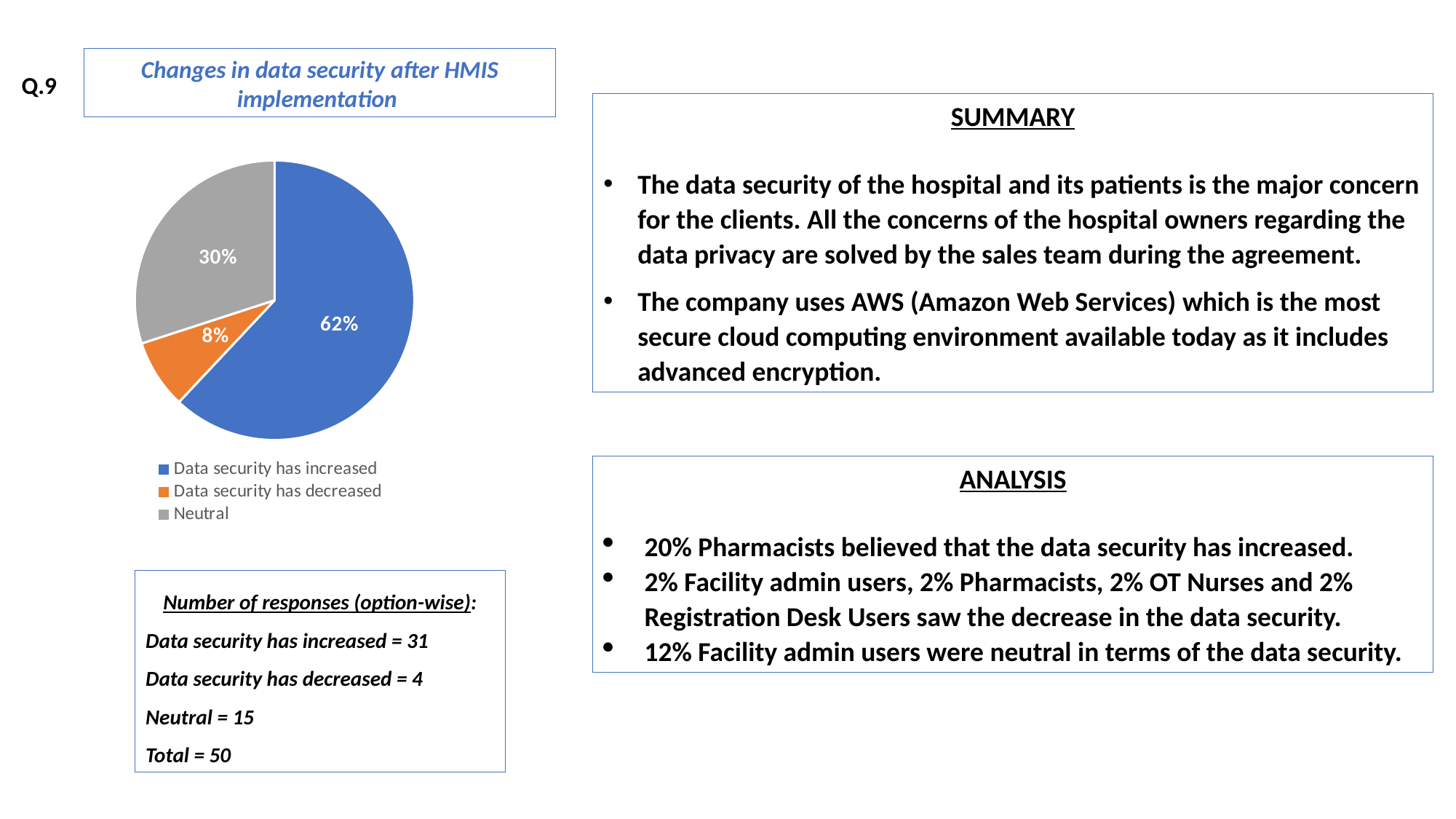
Which category has the largest slice of the pie? Data security has increased Which category has the smallest slice of the pie? Data security has decreased What share of the pie does 'Neutral' represent? 30% What is the title of the chart? Changes in data security after HMIS implementation Which slice is larger: 'Neutral' or 'Data security has decreased'? Neutral What is the difference in percentage points between the 'Data security has increased' and 'Neutral' slices? 32 What share of the pie does 'Data security has increased' represent? 62% What share of the pie does 'Data security has decreased' represent? 8% What kind of chart is shown on the slide? pie chart What colour is the 'Neutral' slice of the pie? grey How many categories does the pie chart show? 3 How many entries does the legend list? 3